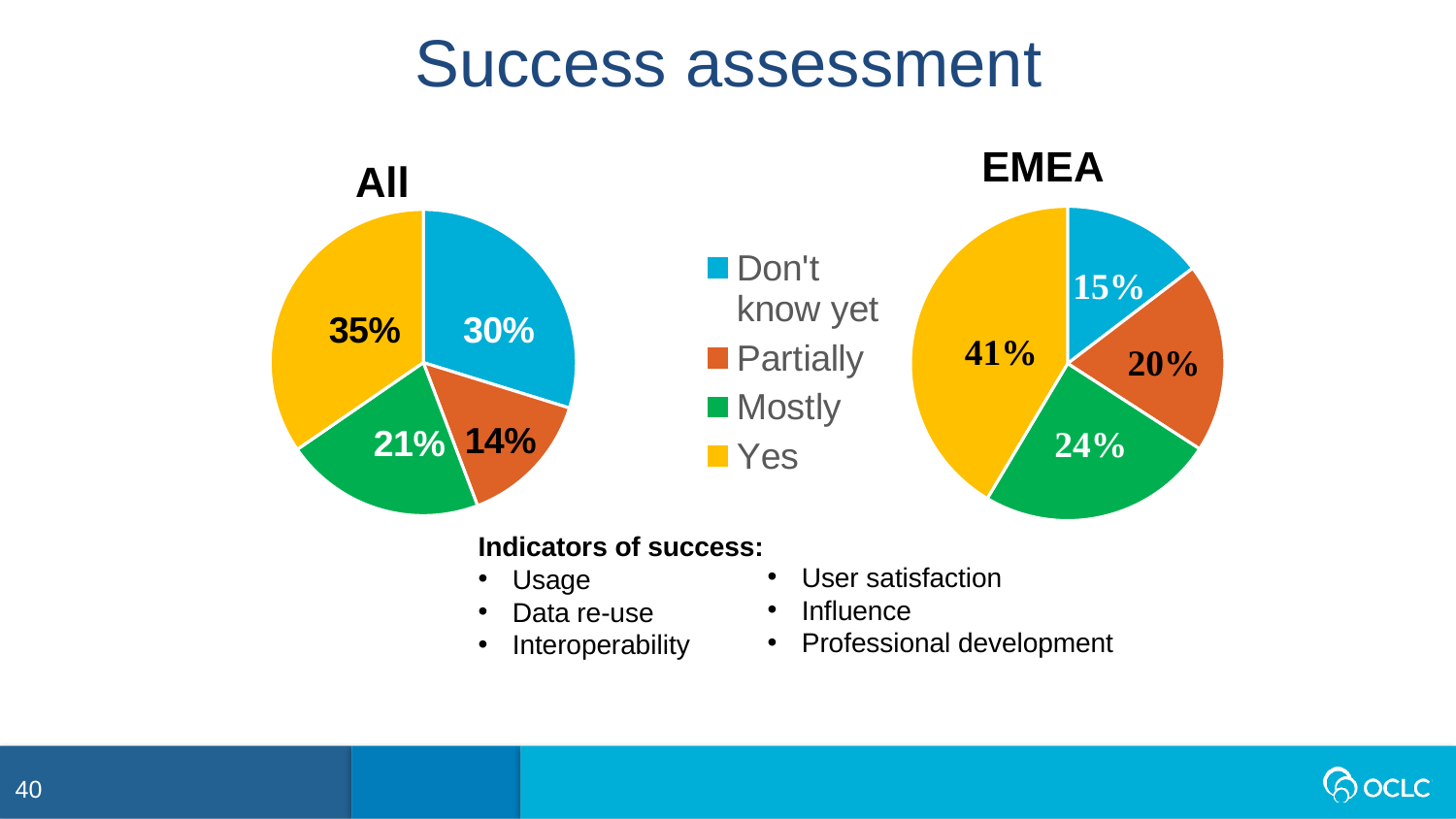
Which colour represents "Mostly" in the legend? Green In the "EMEA" pie chart, what share is labelled for the "Mostly" slice? 24% In the "All" pie chart, what share is labelled for the "Partially" slice? 14% In the "All" pie chart, what is the difference in percentage points between the "Yes" slice and the "Don't know yet" slice? 5 percentage points In the "All" pie chart, which category has the smallest slice? Partially In the "EMEA" pie chart, what is the difference in percentage points between the "Yes" slice and the "Partially" slice? 21 percentage points In the "EMEA" pie chart, which category has the largest slice? Yes How many slices does the "EMEA" pie chart have? 4 In the "All" pie chart, what share is labelled for the "Yes" slice? 35% Is the "Don't know yet" share larger in the "All" pie chart or in the "EMEA" pie chart? All In the "EMEA" pie chart, what share is labelled for the "Don't know yet" slice? 15% What type of chart is used for the "All" chart? Pie chart